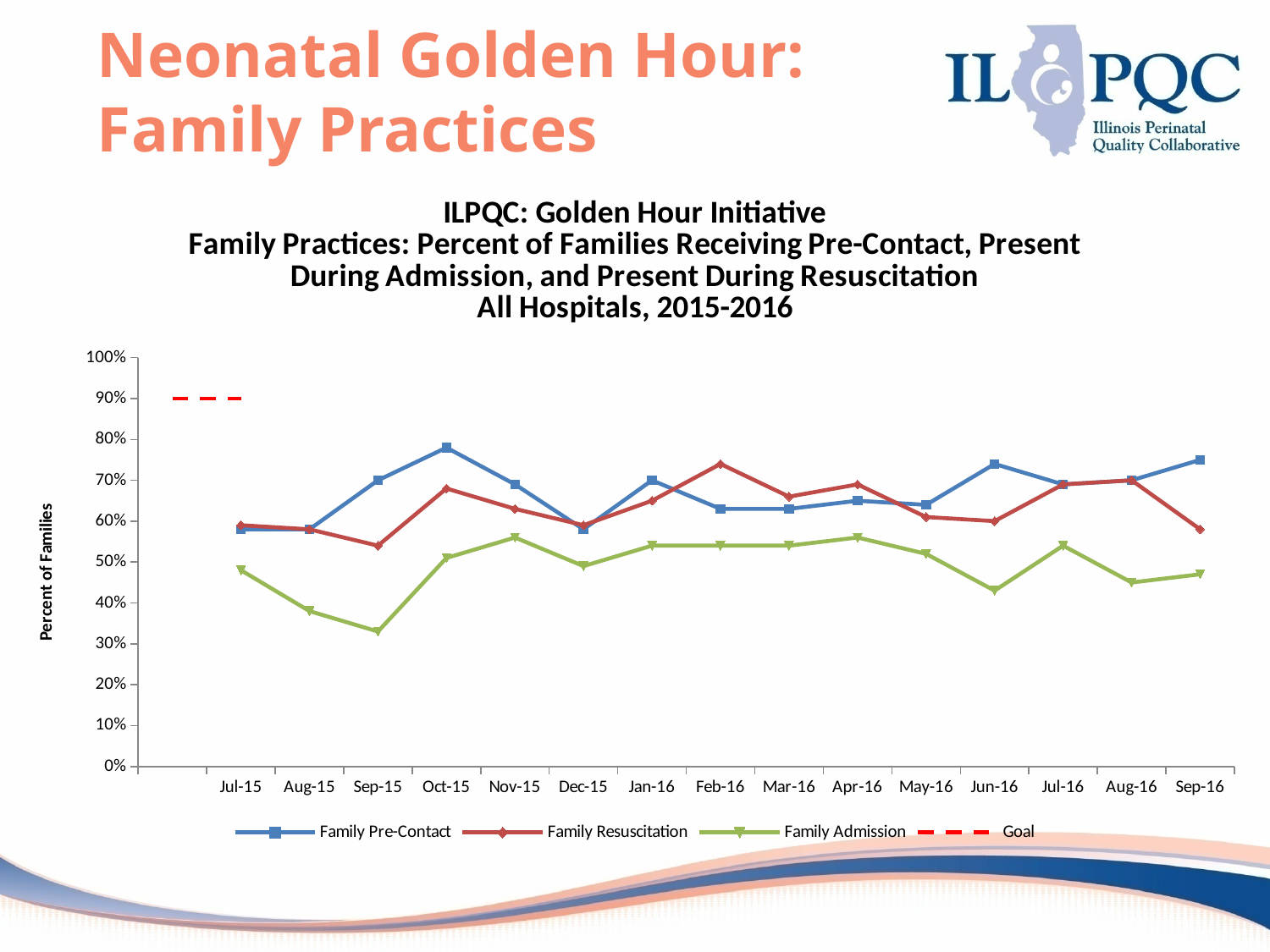
In which month is the Family Pre-Contact value highest? Oct-15 What is the label on the vertical axis? Percent of Families Is the Family Pre-Contact value for Oct-15 greater or less than 70%? greater What kind of chart is shown on the slide? Line chart In which month is the Family Admission value lowest? Sep-15 At what percentage does the Goal line sit? 90% In Sep-16, which is larger: Family Pre-Contact or Family Resuscitation? Family Pre-Contact Is the Family Admission value for Sep-15 greater or less than 40%? less In which month is the Family Resuscitation value lowest? Sep-15 How many months are plotted along the x axis? 15 Does the Family Admission line rise or fall from Jul-15 to Sep-15? Fall How many series does the legend list? 4